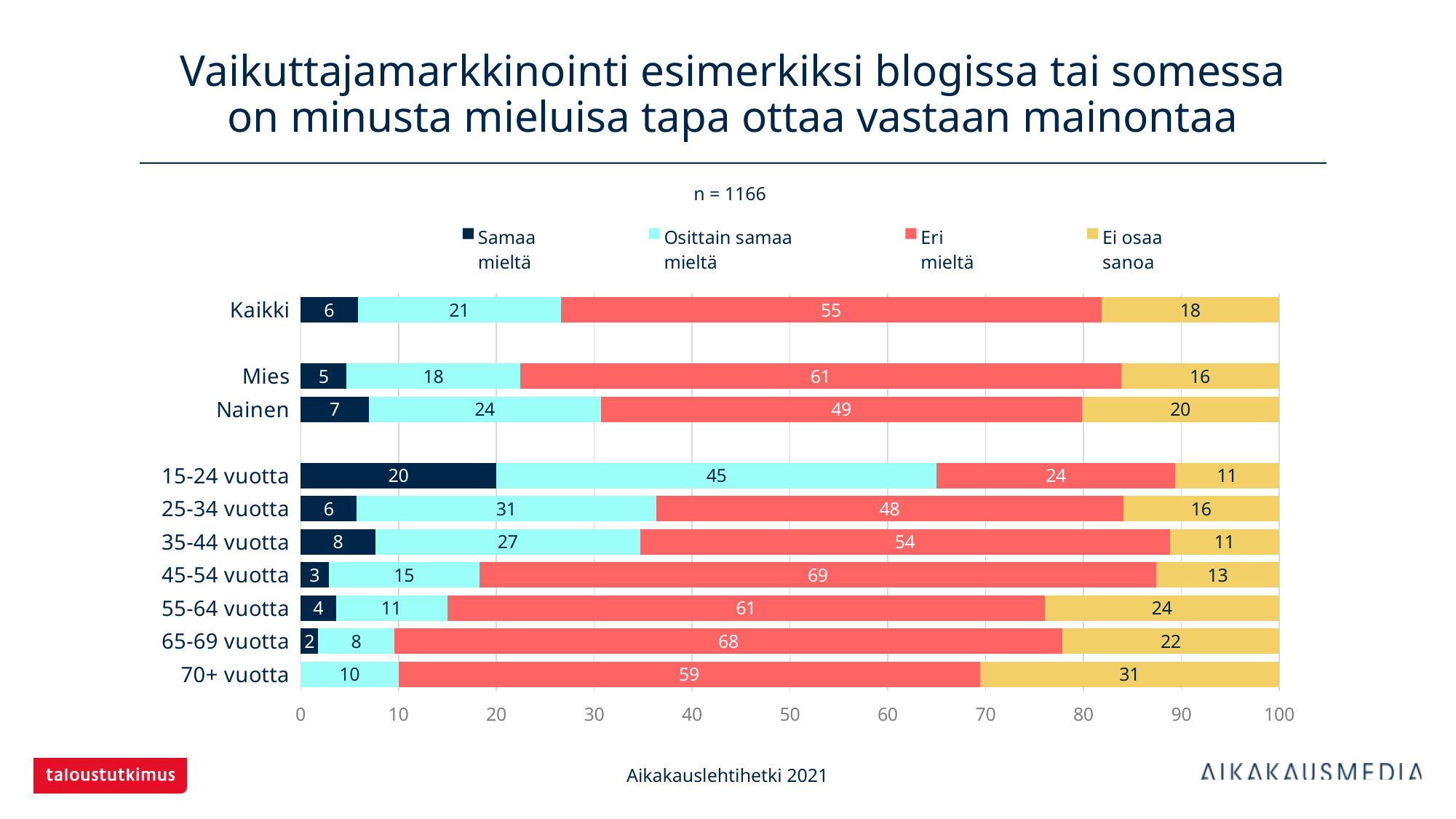
What is the sample size (n) shown on the slide? n = 1166 What kind of chart is shown on the slide? Stacked bar chart How many categories are shown on the y axis? 10 What is the value of "Samaa mieltä" for 65-69 vuotta? 2 Which has the larger "Osittain samaa mieltä" value, Mies or Nainen? Nainen What is the value of "Osittain samaa mieltä" for 15-24 vuotta? 45 What is the difference between the "Eri mieltä" values for Mies and Nainen? 12 Which category has the highest "Eri mieltä" value? 45-54 vuotta How many series does the legend list? 4 Which category has the highest "Samaa mieltä" value? 15-24 vuotta What is the value of "Eri mieltä" for Kaikki? 55 Which category has the highest "Ei osaa sanoa" value? 70+ vuotta